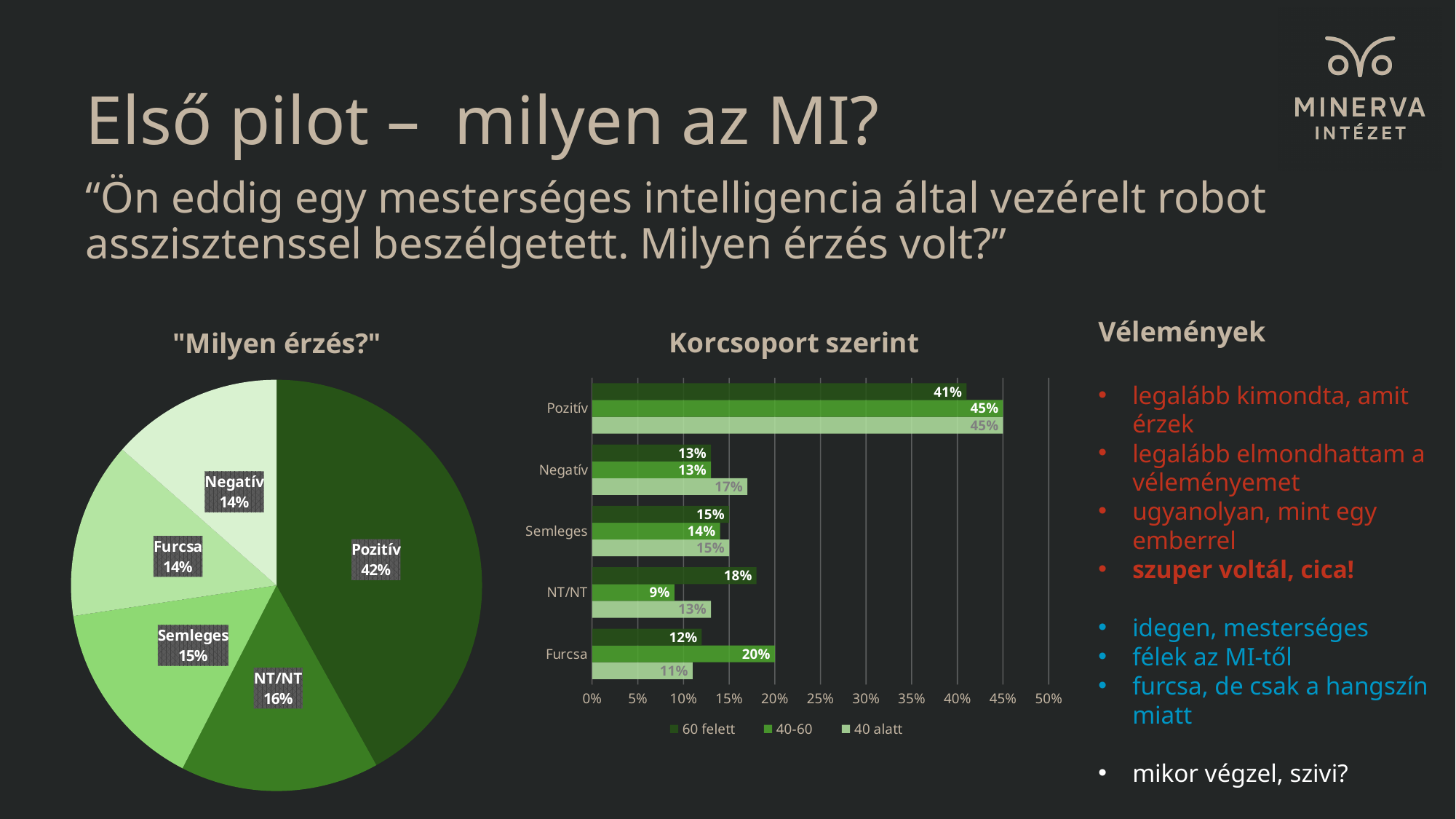
In the "Milyen érzés?" pie chart, what share does Pozitív have? 42% In the "Korcsoport szerint" chart, what is the difference between the 40-60 and 60 felett values for Pozitív? 4% In the "Milyen érzés?" pie chart, what is the share for NT/NT? 16% What type of chart is "Korcsoport szerint"? Bar chart In the "Korcsoport szerint" chart, which category has the highest value in the 60 felett series? Pozitív How many series does the legend of the "Korcsoport szerint" chart list? 3 In the "Korcsoport szerint" chart, what is the value for Furcsa in the 40-60 series? 20% In the "Korcsoport szerint" chart, which is larger for Negatív: the 40 alatt value or the 60 felett value? 40 alatt In the "Korcsoport szerint" chart, what is the value for Semleges in the 40 alatt series? 15% In the "Milyen érzés?" pie chart, which slice is the largest? Pozitív In the "Korcsoport szerint" chart, what is the value for NT/NT in the 40-60 series? 9% How many slices does the "Milyen érzés?" pie chart have? 5